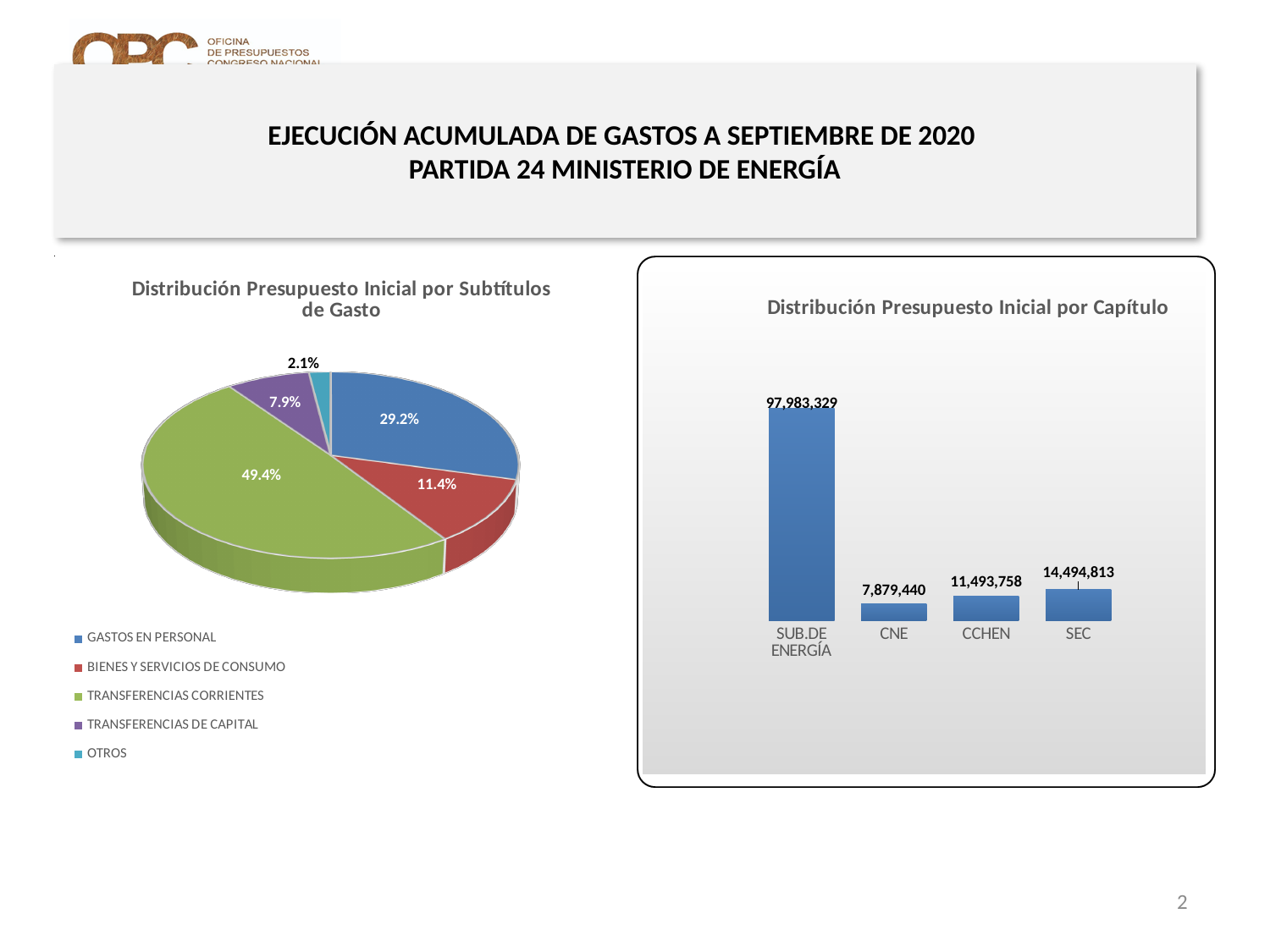
How many categories are shown in the 'Distribución Presupuesto Inicial por Capítulo' chart? 4 In the 'Distribución Presupuesto Inicial por Capítulo' chart, what is the value for SUB.DE ENERGÍA? 97,983,329 What kind of chart is 'Distribución Presupuesto Inicial por Capítulo'? Bar chart In the 'Distribución Presupuesto Inicial por Capítulo' chart, which category has the highest value? SUB.DE ENERGÍA How many entries does the legend of the 'Distribución Presupuesto Inicial por Subtítulos de Gasto' pie chart list? 5 In the 'Distribución Presupuesto Inicial por Capítulo' chart, what is the difference between SEC and CCHEN? 3,001,055 In the 'Distribución Presupuesto Inicial por Capítulo' chart, which category has the lowest value? CNE In the 'Distribución Presupuesto Inicial por Capítulo' chart, which is larger, SEC or CNE? SEC In the 'Distribución Presupuesto Inicial por Subtítulos de Gasto' pie chart, what share does GASTOS EN PERSONAL have? 29.2% In the 'Distribución Presupuesto Inicial por Capítulo' chart, what is the value for CNE? 7,879,440 In the 'Distribución Presupuesto Inicial por Capítulo' chart, what is the value for CCHEN? 11,493,758 In the 'Distribución Presupuesto Inicial por Subtítulos de Gasto' pie chart, what share does TRANSFERENCIAS CORRIENTES have? 49.4%